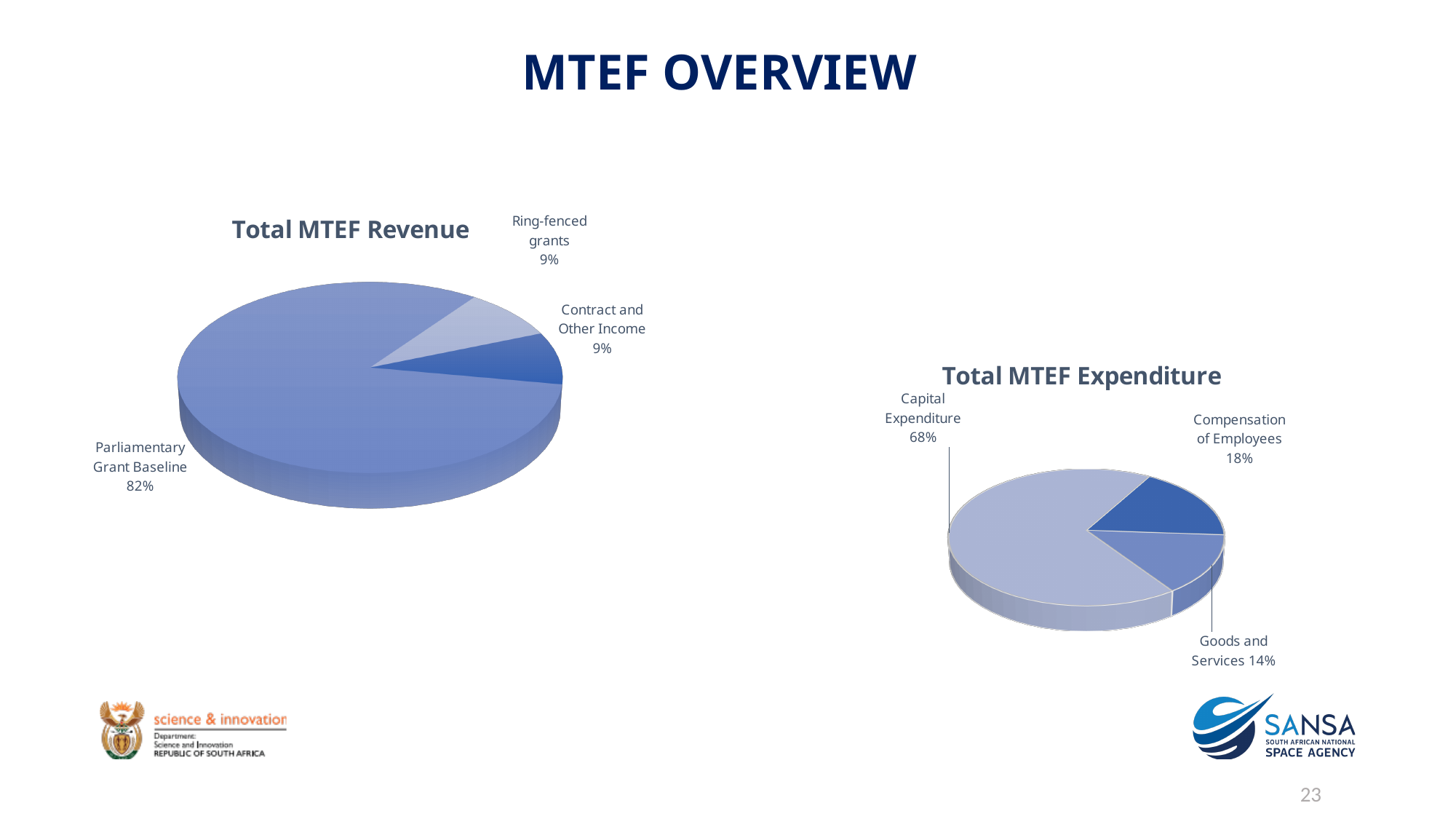
In the Total MTEF Revenue chart, what share does Ring-fenced grants have? 9% In the Total MTEF Revenue chart, what is the difference between the Parliamentary Grant Baseline share and the Contract and Other Income share? 73% In the Total MTEF Expenditure chart, which is larger: Compensation of Employees or Goods and Services? Compensation of Employees In the Total MTEF Revenue chart, what share does Parliamentary Grant Baseline have? 82% In the Total MTEF Revenue chart, which category has the largest slice? Parliamentary Grant Baseline In the Total MTEF Revenue chart, how many slices does the pie have? 3 In the Total MTEF Expenditure chart, what share does Goods and Services have? 14% What kind of chart is the Total MTEF Revenue chart? Pie chart In the Total MTEF Expenditure chart, which category has the smallest slice? Goods and Services In the Total MTEF Expenditure chart, what is the difference between the Capital Expenditure share and the Compensation of Employees share? 50% How many charts are shown on the slide? 2